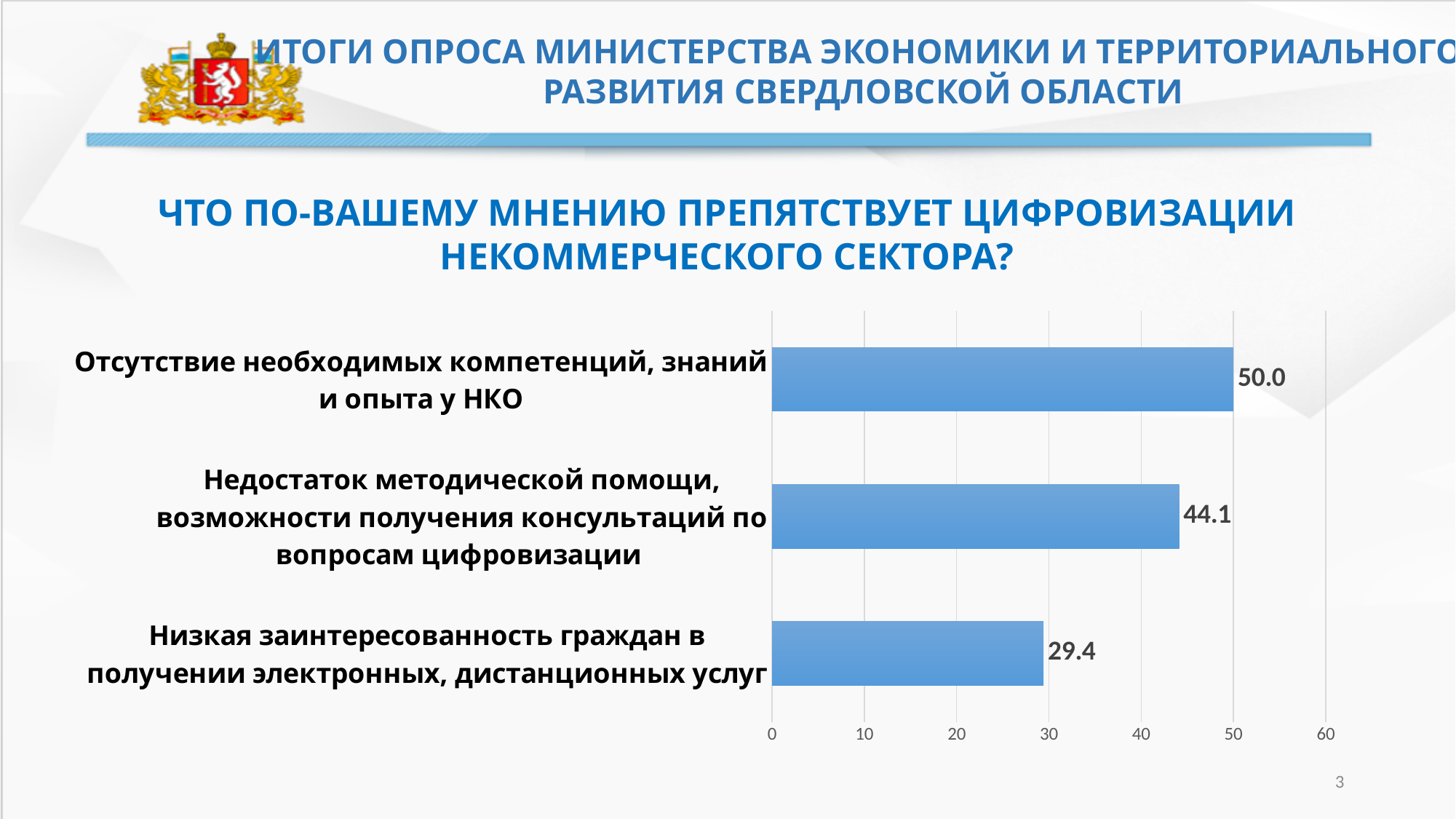
What is the difference between the values for "Отсутствие необходимых компетенций, знаний и опыта у НКО" and "Низкая заинтересованность граждан в получении электронных, дистанционных услуг"? 20.6 What is the value for "Недостаток методической помощи, возможности получения консультаций по вопросам цифровизации"? 44.1 How many categories are shown in the chart? 3 What is the value for "Отсутствие необходимых компетенций, знаний и опыта у НКО"? 50.0 What is the maximum value shown on the horizontal axis? 60 Is the value for "Недостаток методической помощи, возможности получения консультаций по вопросам цифровизации" greater or less than 40? greater What is the difference between the values for "Отсутствие необходимых компетенций, знаний и опыта у НКО" and "Недостаток методической помощи, возможности получения консультаций по вопросам цифровизации"? 5.9 Which category has the highest value? Отсутствие необходимых компетенций, знаний и опыта у НКО What kind of chart is shown on the slide? bar chart Which is larger: the value for "Недостаток методической помощи, возможности получения консультаций по вопросам цифровизации" or for "Низкая заинтересованность граждан в получении электронных, дистанционных услуг"? Недостаток методической помощи, возможности получения консультаций по вопросам цифровизации Which category has the lowest value? Низкая заинтересованность граждан в получении электронных, дистанционных услуг What is the value for "Низкая заинтересованность граждан в получении электронных, дистанционных услуг"? 29.4